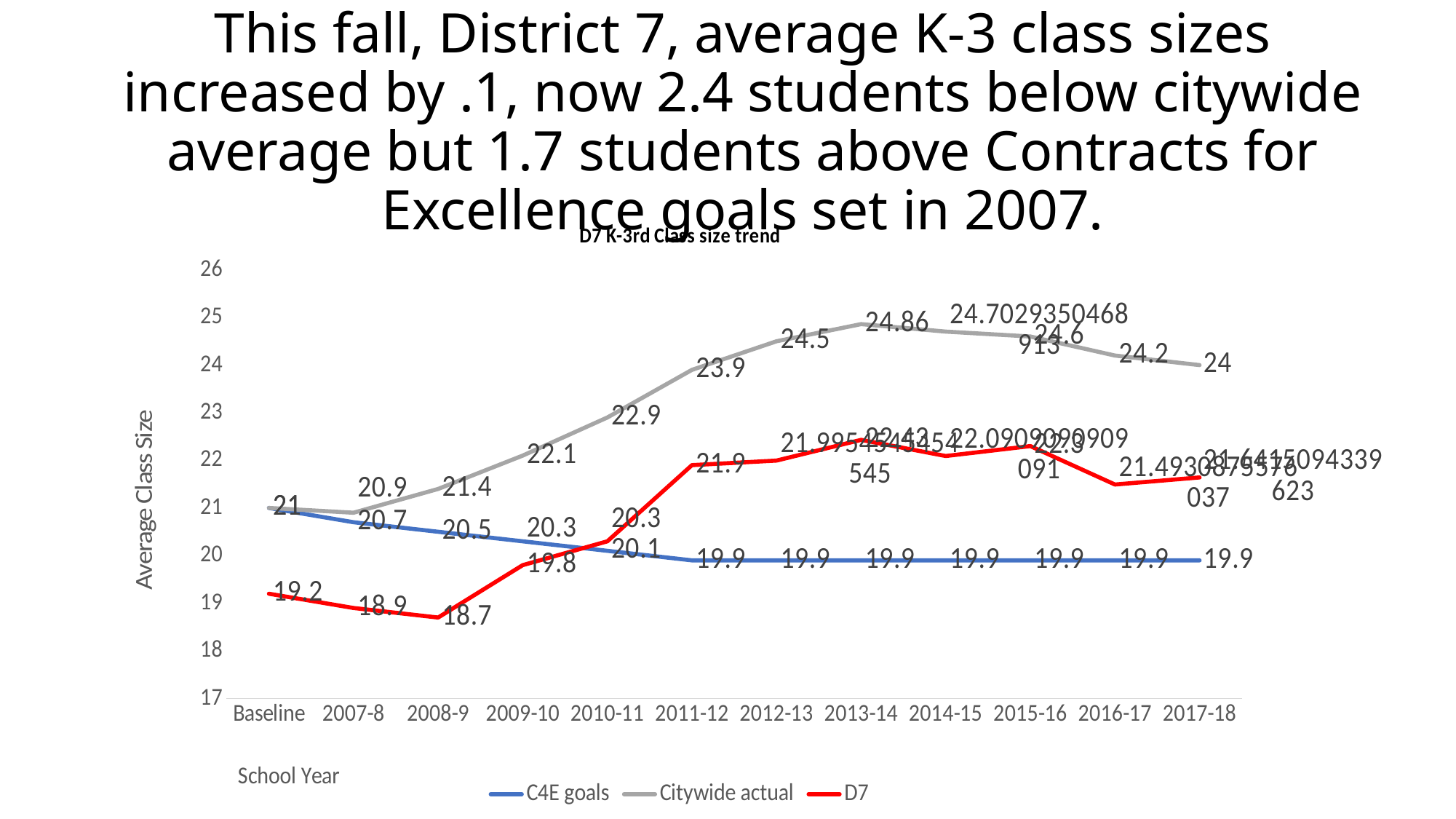
In which school year is the D7 series at its lowest? 2008-9 What kind of chart is shown on the slide? line chart How many series does the legend list? 3 What is the D7 value for 2008-9? 18.7 Does the C4E goals series rise or fall from Baseline to 2011-12? fall What is the difference between the Citywide actual value and the C4E goals value in 2017-18? 4.1 In which school year does the Citywide actual series reach its highest value? 2013-14 What is the Citywide actual value for 2010-11? 22.9 What is the Citywide actual value for 2011-12? 23.9 At Baseline, which is larger: the C4E goals value or the D7 value? C4E goals How many school years are plotted along the x axis? 12 What is the C4E goals value for 2017-18? 19.9